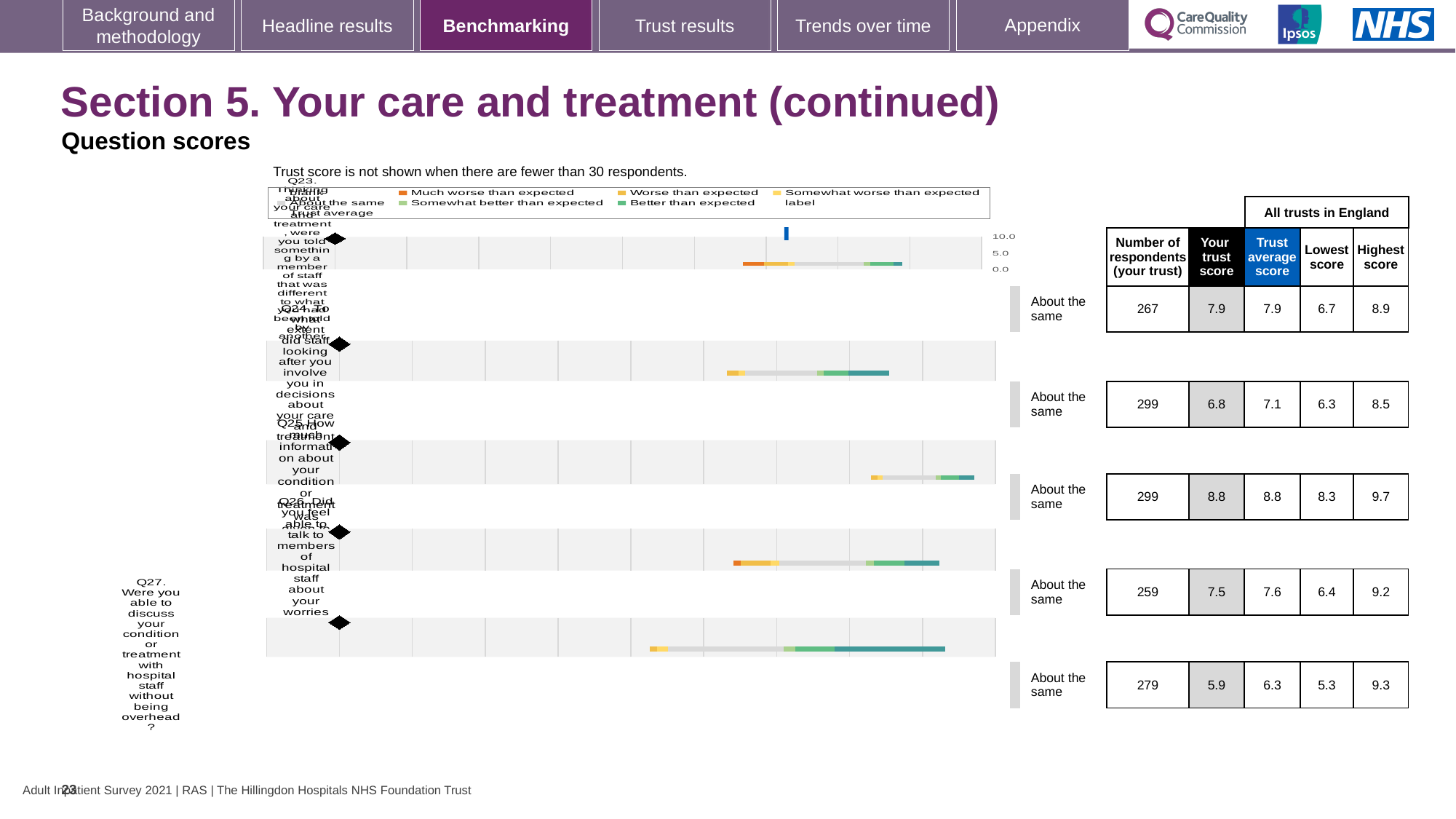
Which question has the lowest 'Your trust score'? Q27 What is the lowest score across all trusts in England for Q27? 5.3 Which has the larger 'Your trust score', Q23 or Q24? Q23 Which question has the highest 'Your trust score'? Q25 What benchmark category is shown next to each question's bar? About the same How many respondents (your trust) are shown for Q23? 267 What is the highest score across all trusts in England for Q26? 9.2 How many questions (Q23 to Q27) are plotted on the chart? 5 What is the 'Your trust score' for Q24? 6.8 What kind of chart is used to show the question scores? Bar chart What is the difference between the trust average score and 'Your trust score' for Q27? 0.4 What is the trust average score for Q25? 8.8